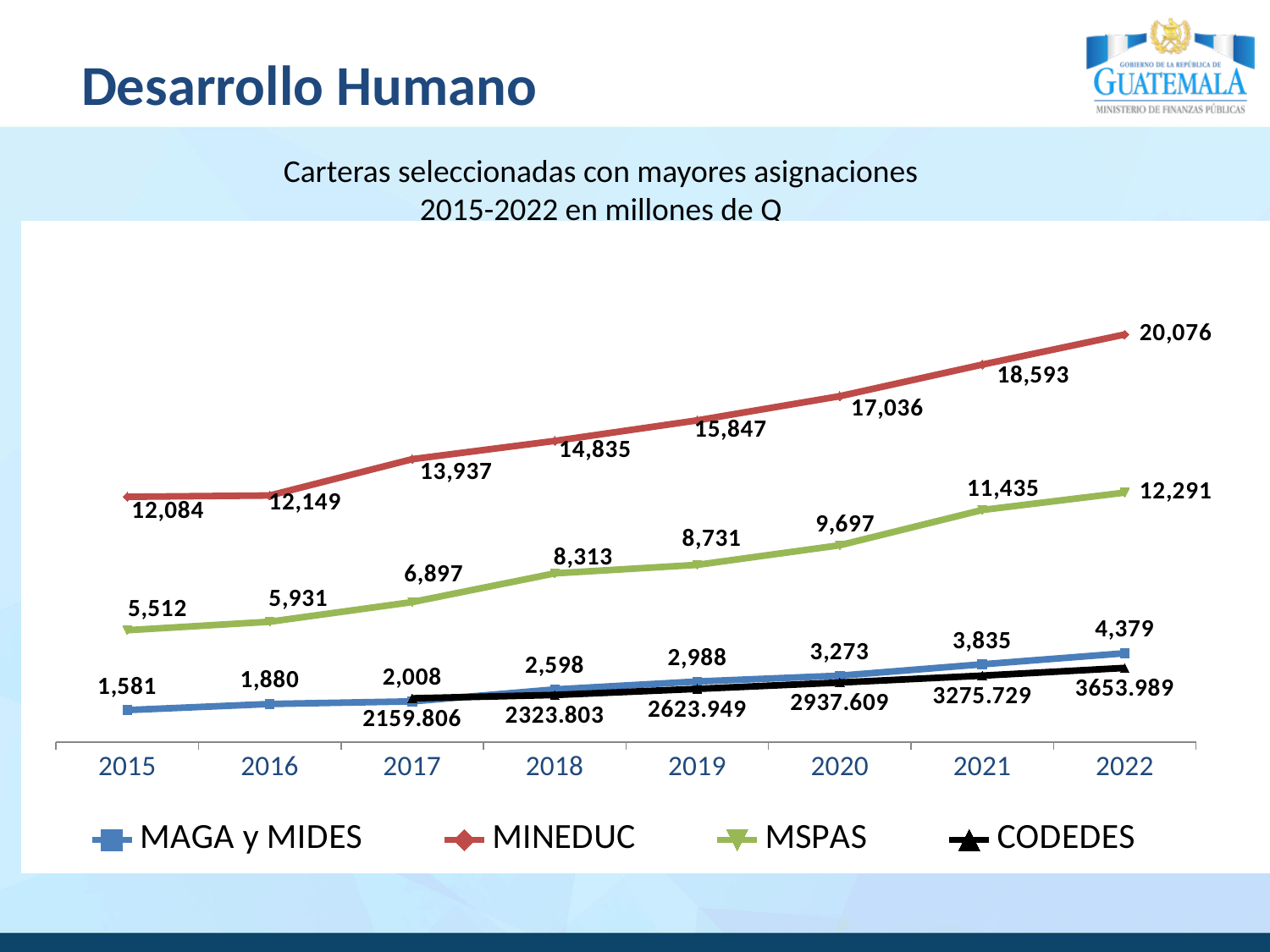
What is the value for MSPAS in 2018? 8,313 Which series has the highest value in 2022? MINEDUC What is the difference between the MINEDUC values in 2022 and 2015? 7,992 How many series does the legend list? 4 In which year is the MSPAS value lowest? 2015 How many years are shown on the x axis? 8 What type of chart is shown on the slide? line chart What is the value for MINEDUC in 2022? 20,076 What is the value for CODEDES in 2020? 2937.609 Which is larger in 2021, the value for MAGA y MIDES or the value for CODEDES? MAGA y MIDES Do the MINEDUC values rise or fall from 2015 to 2022? rise What is the value for MAGA y MIDES in 2015? 1,581